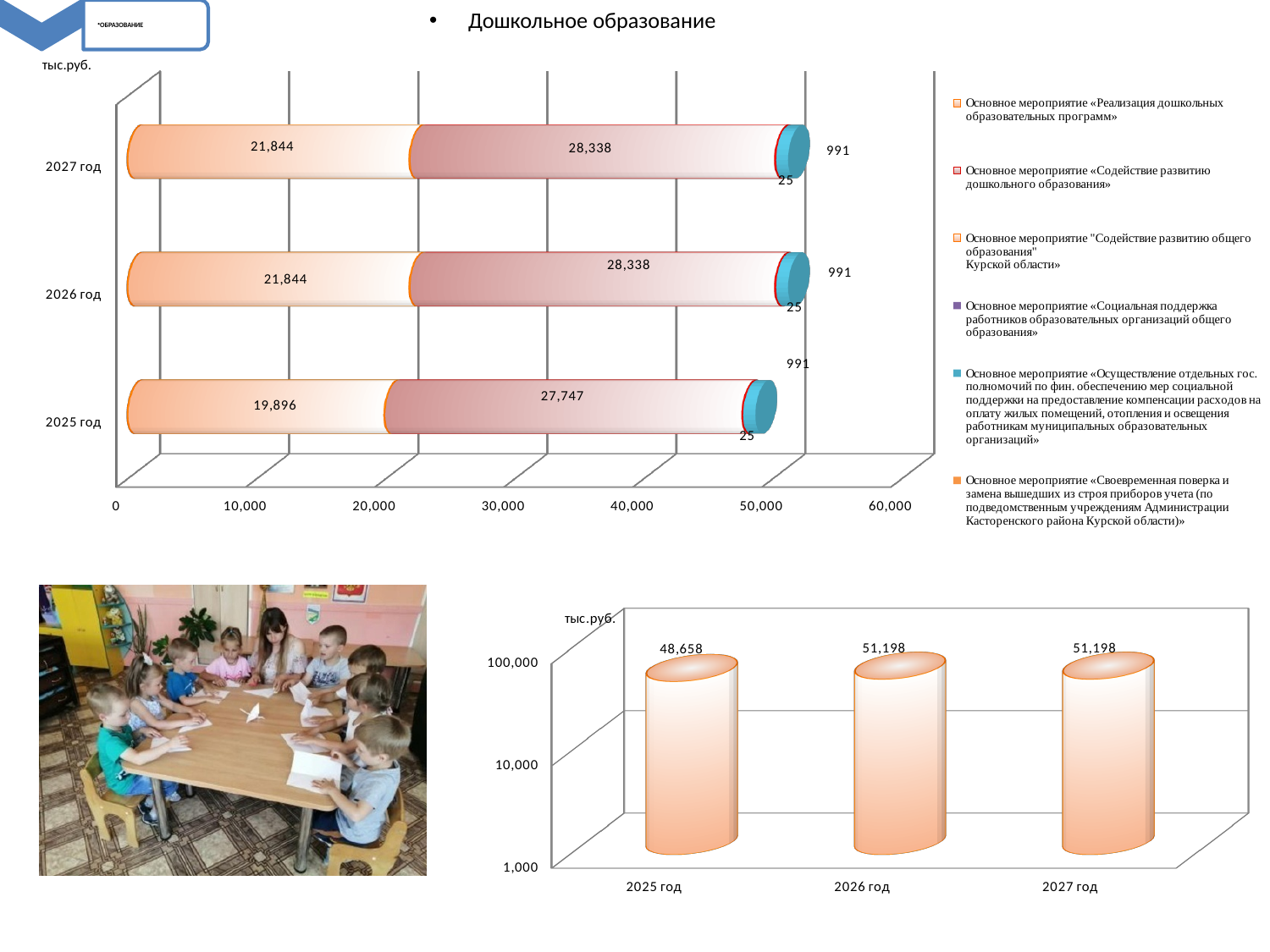
What kind of chart is the top chart? Stacked bar chart In the top chart, what is the value of the first (leftmost) segment of the bar for 2026 год? 21,844 In the bottom chart, what is the difference between the values for 2026 год and 2025 год? 2,540 In the top chart, what is the value of the first (leftmost) segment of the bar for 2025 год? 19,896 In the top chart, what is the difference between the second segment values for 2026 год and 2025 год? 591 In the top chart, how many series does the legend list? 6 In the bottom chart, is the value for 2027 год greater or less than 10,000? greater In the top chart, what is the value of the second segment of the bar for 2027 год? 28,338 In the bottom chart, what is the value for 2025 год? 48,658 In the bottom chart, which year has the lowest value? 2025 год In the top chart, what is the difference between the first segment values for 2027 год and 2025 год? 1,948 In the top chart, how many year categories are shown? 3